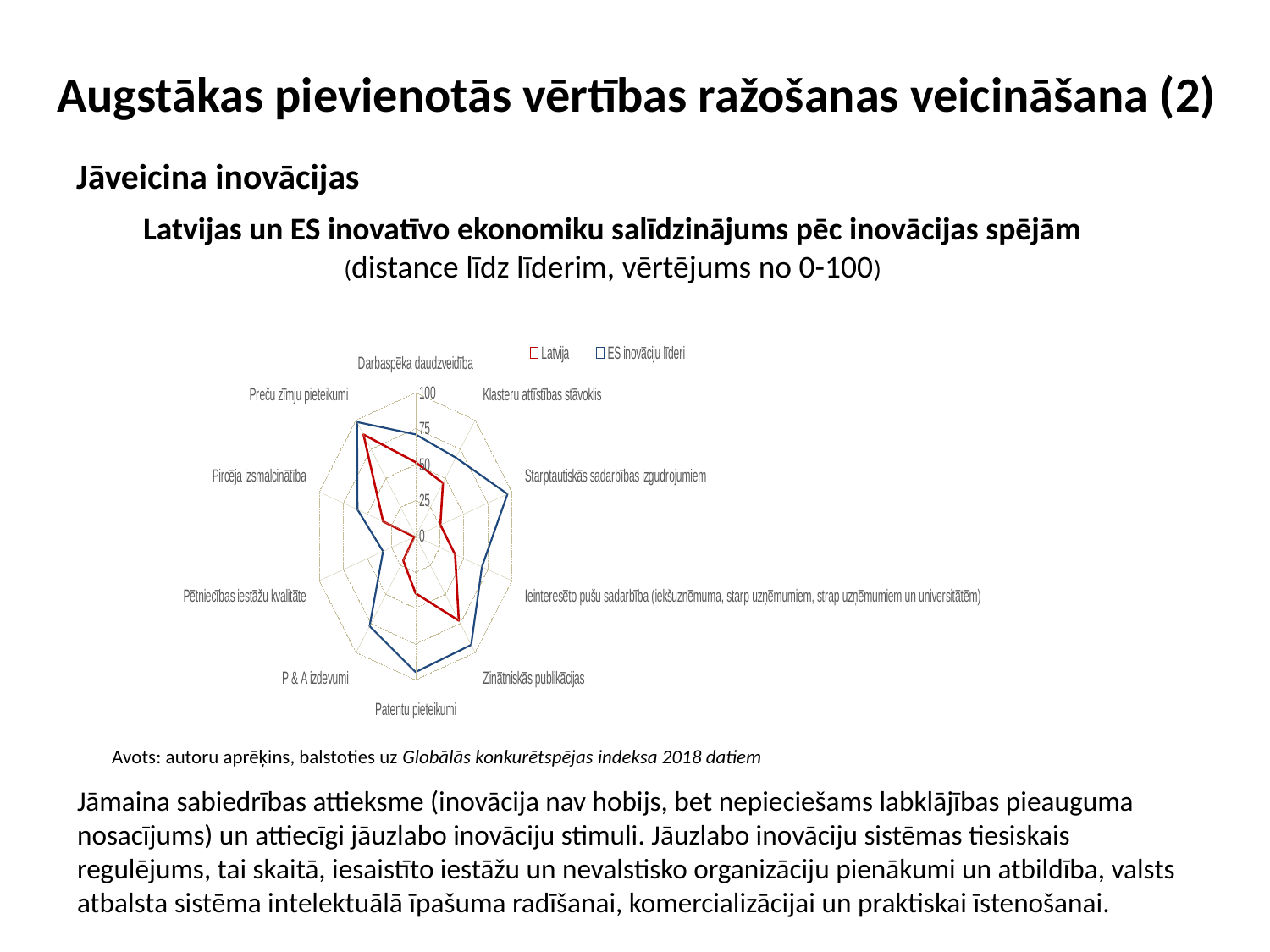
Is the value for Latvija on Starptautiskās sadarbības izgudrojumiem greater or less than 50? less For Zinātniskās publikācijas, which series has the larger value, Latvija or ES inovāciju līderi? ES inovāciju līderi Is the value for ES inovāciju līderi on Starptautiskās sadarbības izgudrojumiem greater or less than 50? greater For Starptautiskās sadarbības izgudrojumiem, which series has the larger value, Latvija or ES inovāciju līderi? ES inovāciju līderi How many categories (axes) does the radar chart have? 10 For Patentu pieteikumi, which series has the larger value, Latvija or ES inovāciju līderi? ES inovāciju līderi Is the value for ES inovāciju līderi on Patentu pieteikumi greater or less than 75? greater How many series does the chart legend list? 2 Which series is drawn in red on the chart? Latvija What kind of chart is shown on the slide? radar chart What is the highest value shown on the chart's axis scale? 100